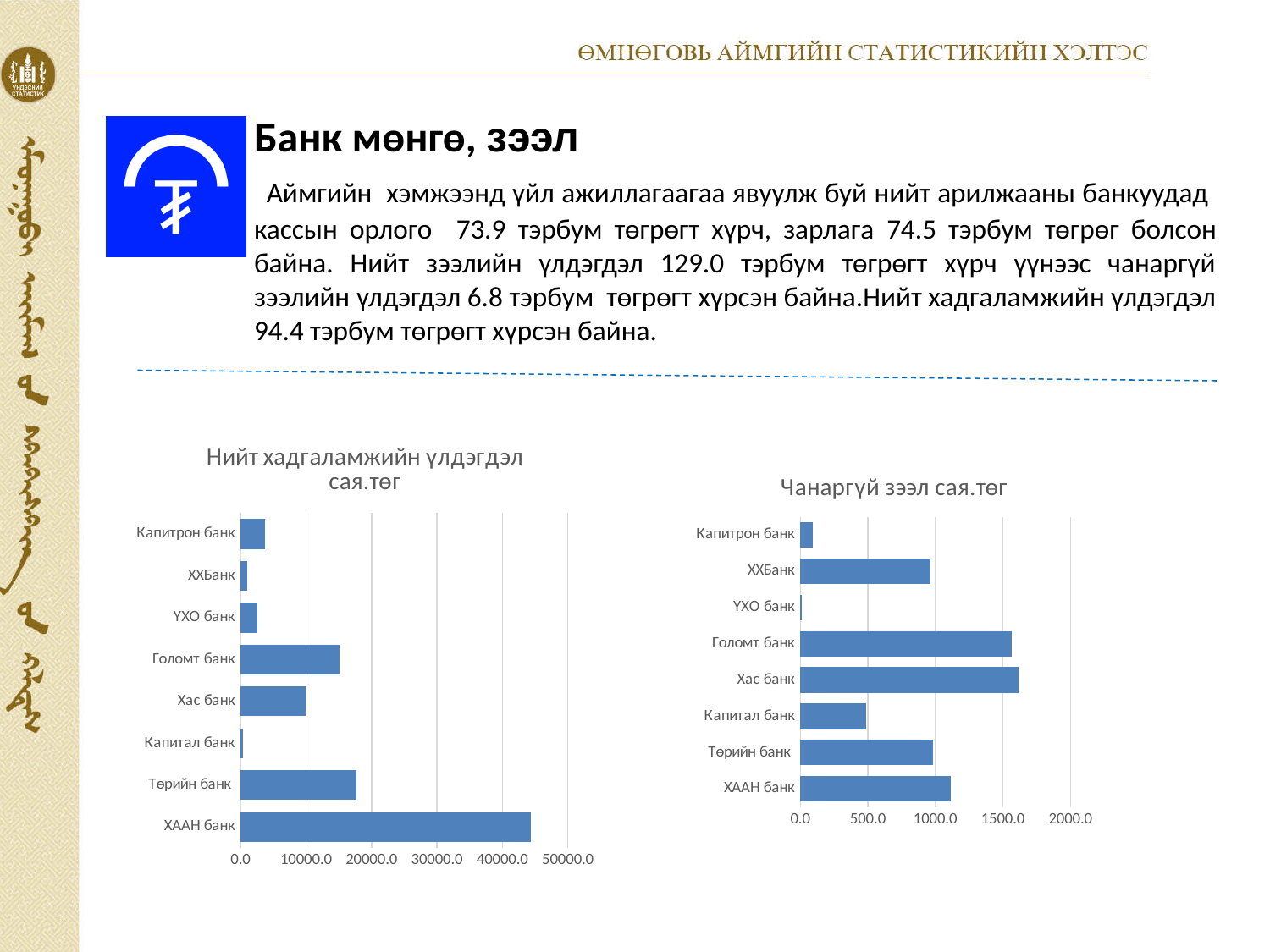
How many banks are shown in the 'Чанаргүй зээл сая.төг' chart? 8 In the 'Чанаргүй зээл сая.төг' chart, which bank has the lowest value? ҮХО банк In the 'Нийт хадгаламжийн үлдэгдэл сая.төг' chart, which bank has the highest value? ХААН банк In the 'Чанаргүй зээл сая.төг' chart, which is larger, Хас банк or Капитал банк? Хас банк In the 'Нийт хадгаламжийн үлдэгдэл сая.төг' chart, which is larger, Хас банк or Капитрон банк? Хас банк In the 'Нийт хадгаламжийн үлдэгдэл сая.төг' chart, is the value for Төрийн банк greater or less than 20000.0? less What type of chart is the 'Нийт хадгаламжийн үлдэгдэл сая.төг' chart? bar chart How many banks are shown in the 'Нийт хадгаламжийн үлдэгдэл сая.төг' chart? 8 In the 'Нийт хадгаламжийн үлдэгдэл сая.төг' chart, is the value for ХААН банк greater or less than 40000.0? greater In the 'Нийт хадгаламжийн үлдэгдэл сая.төг' chart, which is larger, Төрийн банк or Голомт банк? Төрийн банк In the 'Чанаргүй зээл сая.төг' chart, is the value for Голомт банк greater or less than 1500.0? greater